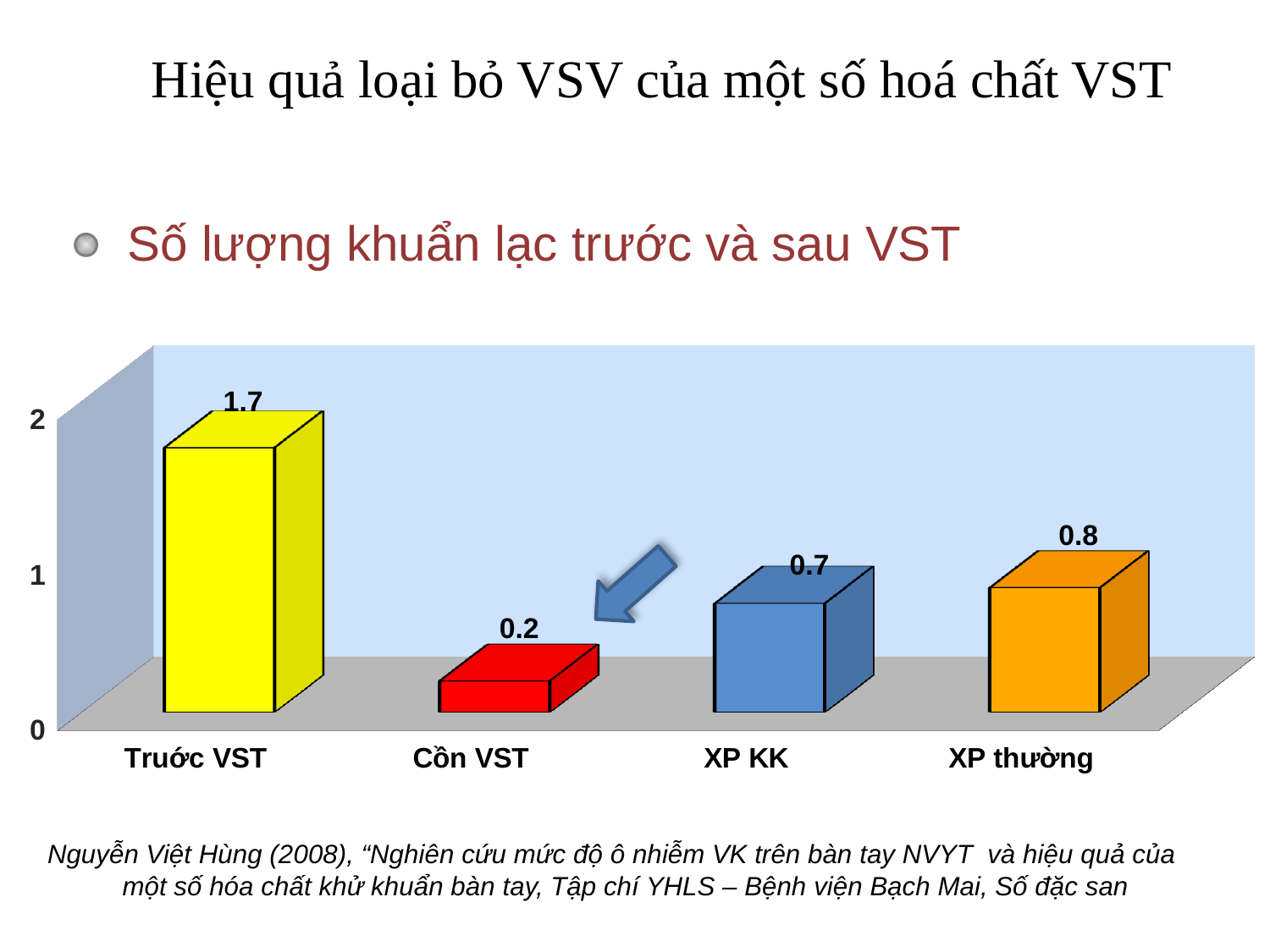
Is the value for Trước VST greater or less than 1? greater What is the difference between the values for XP thường and XP KK? 0.1 What is the difference between the values for Trước VST and Cồn VST? 1.5 What is the value for Cồn VST? 0.2 What is the value for XP thường? 0.8 Which category has the highest value? Trước VST How many categories are shown on the x axis? 4 Which is larger, the value for XP KK or the value for Cồn VST? XP KK What kind of chart is shown on the slide? bar chart What is the value for Trước VST? 1.7 Which category has the lowest value? Cồn VST What is the value for XP KK? 0.7